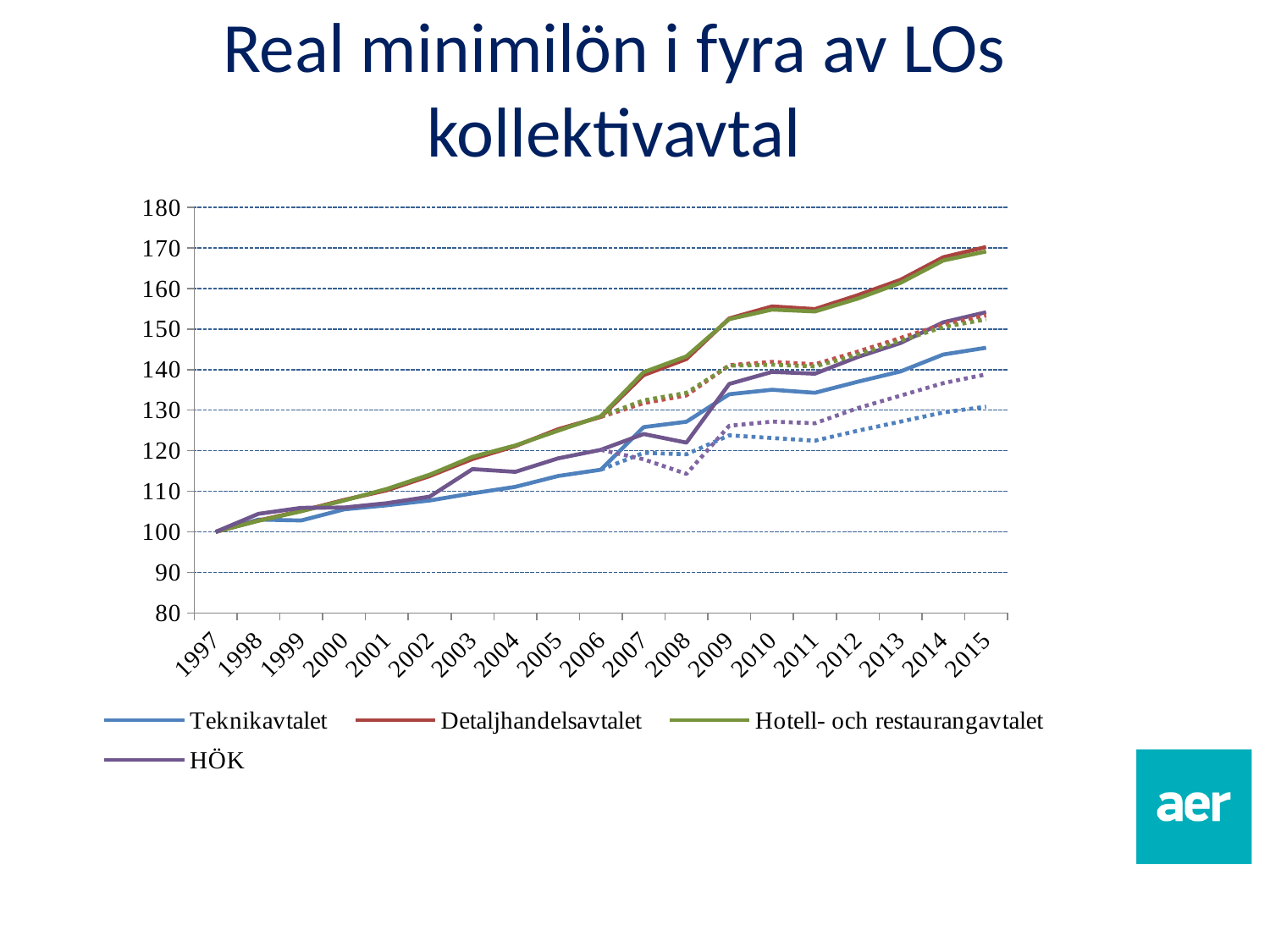
Is the value for Hotell- och restaurangavtalet in 2005 greater or less than 130? less How many series does the legend list? 4 Is the value for Teknikavtalet in 2015 greater or less than 140? greater Is the value for Teknikavtalet in 2011 greater or less than 140? less How many years are shown along the x axis? 19 Do the values for Detaljhandelsavtalet generally rise or fall from 1997 to 2015? rise What kind of chart is shown on the slide? line chart What is the value of Teknikavtalet in 1997? 100 What is the title of the chart? Real minimilön i fyra av LOs kollektivavtal Which of the four legend series has the lowest value in 2015? Teknikavtalet Which is larger in 2015, Detaljhandelsavtalet or Teknikavtalet? Detaljhandelsavtalet